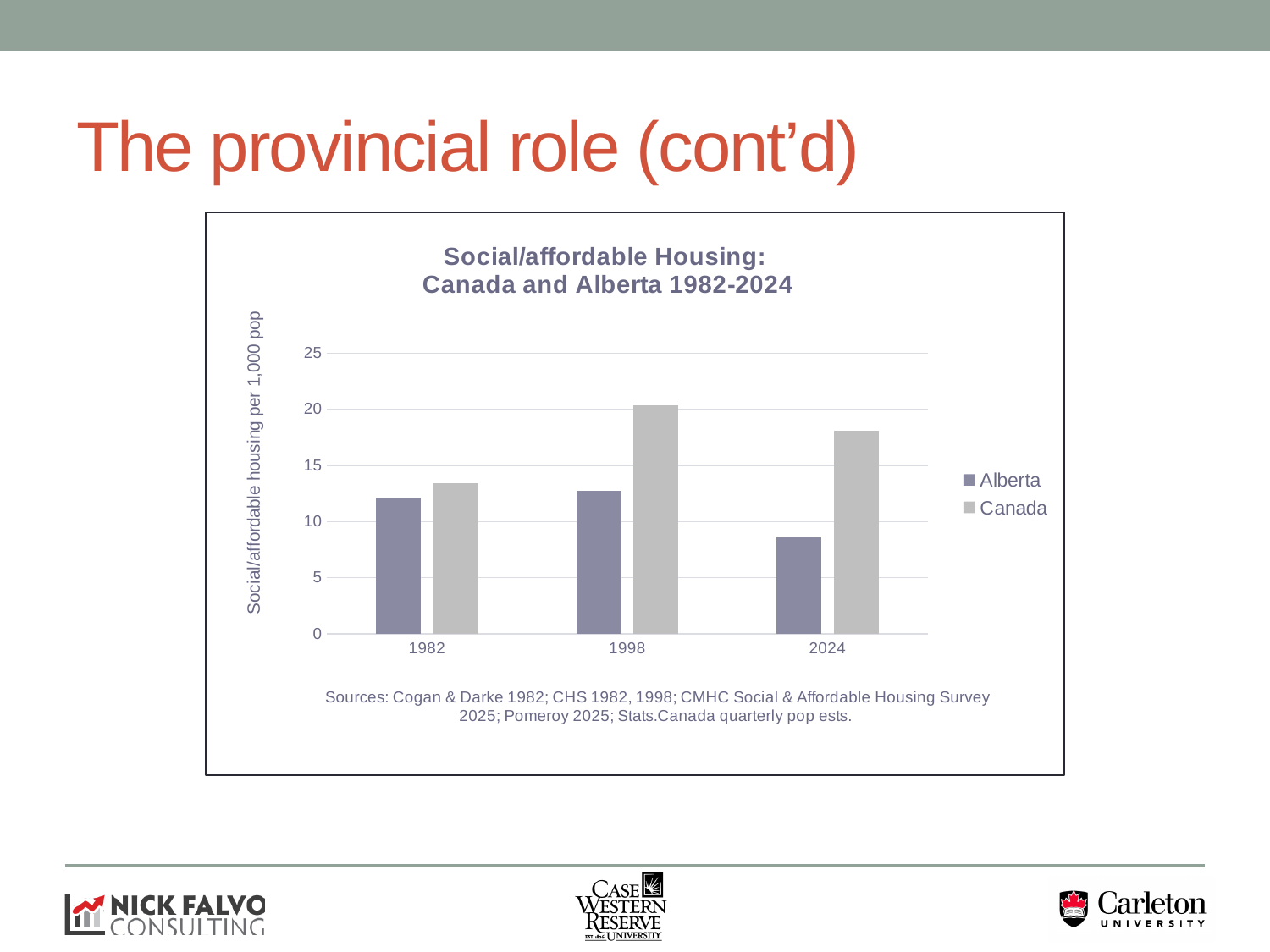
Is the value for Alberta in 2024 greater or less than 10? less In 1998, which is larger, the Alberta value or the Canada value? Canada What kind of chart is shown on the slide? Bar chart In 2024, which is larger, the Alberta value or the Canada value? Canada Is the value for Canada in 2024 greater or less than 20? less How many years are shown on the x axis of the chart? 3 What is the label on the chart's y axis? Social/affordable housing per 1,000 pop Is the value for Canada in 1998 greater or less than 15? greater What is the title of the chart? Social/affordable Housing: Canada and Alberta 1982-2024 In which year is the Alberta bar lowest? 2024 In which year is the Canada bar highest? 1998 How many series does the chart's legend list? 2